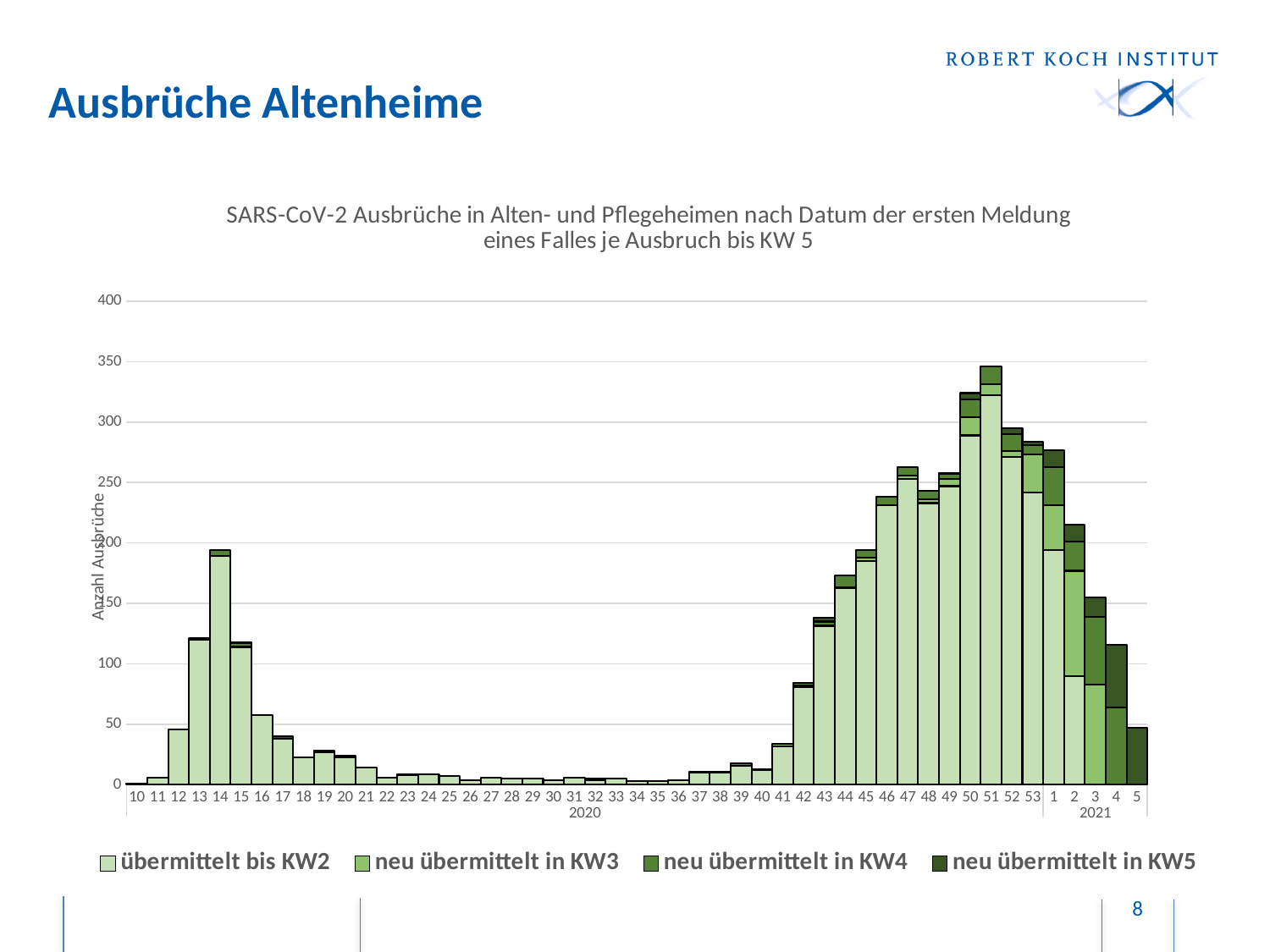
Which legend entry is shown in the lightest green? übermittelt bis KW2 Is the total value for KW 30 of 2020 greater or less than 50? less Do the total values rise or fall from KW 1 to KW 5 of 2021? fall Is the total value for KW 14 of 2020 greater or less than 150? greater How many series does the legend list? 4 How many calendar weeks are shown on the x axis? 49 Which has the larger total, KW 13 or KW 14 of 2020? KW 14 Is the total value for KW 5 of 2021 greater or less than 100? less What kind of chart is shown on the slide? Stacked bar chart What is the title of the chart? SARS-CoV-2 Ausbrüche in Alten- und Pflegeheimen nach Datum der ersten Meldung eines Falles je Ausbruch bis KW 5 Which calendar week has the highest total number of outbreaks? KW 51 (2020)